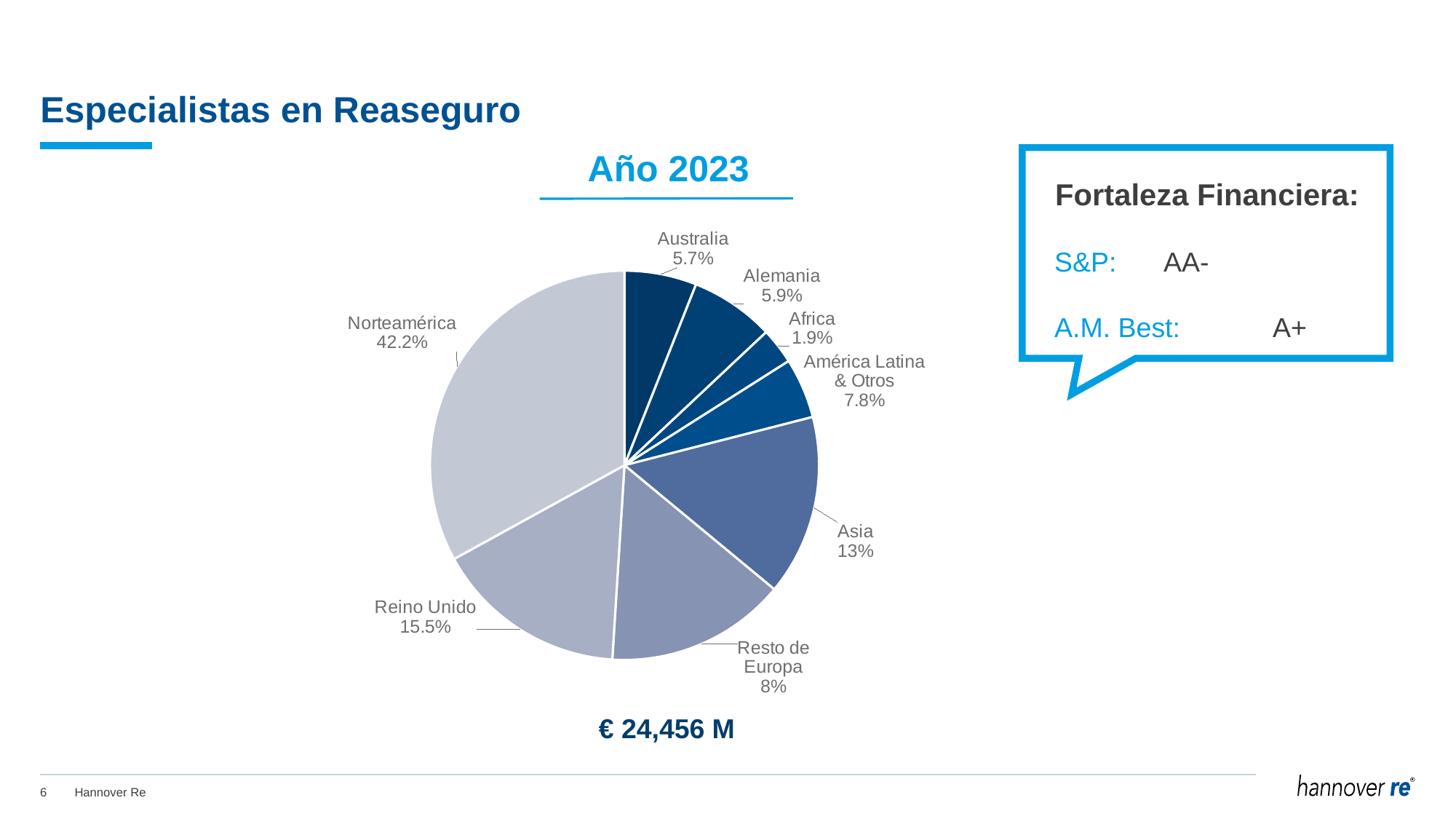
What total amount is shown below the pie chart? € 24,456 M What is the title of the pie chart? Año 2023 What is the value shown for América Latina & Otros? 7.8% What share of the pie does Norteamérica represent? 42.2% What is the value shown for Asia? 13% What is the value shown for Reino Unido? 15.5% What type of chart is shown on the slide? pie chart Which is larger, the share for Alemania or the share for Australia? Alemania How many slices does the pie chart have? 8 Which region has the smallest slice of the pie? Africa Which region has the largest slice of the pie? Norteamérica What is the difference in percentage points between Reino Unido and Asia? 2.5